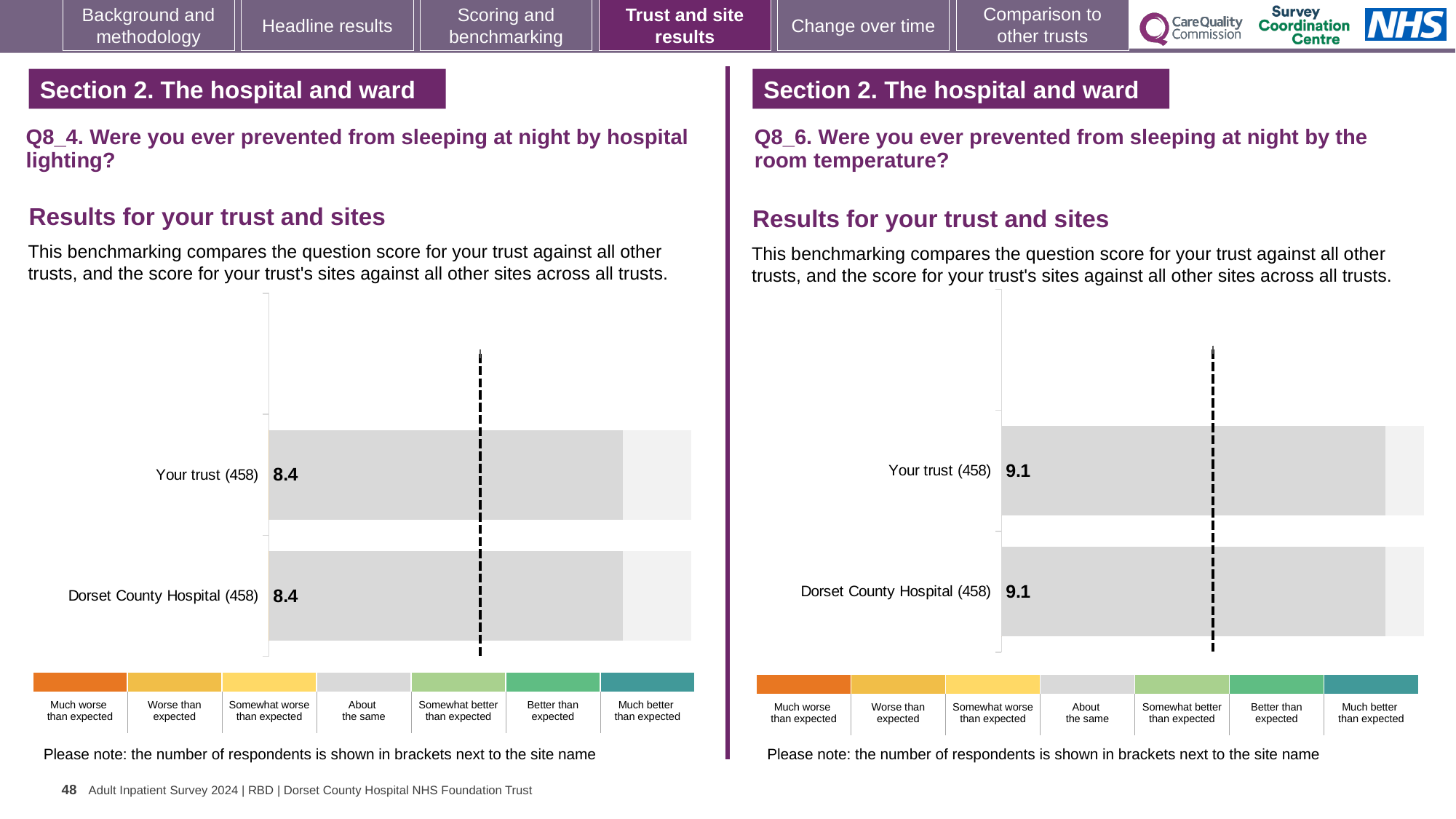
On the right chart (Q8_6, room temperature), what is the score for Dorset County Hospital (458)? 9.1 What kind of chart is used on the left (Q8_4, hospital lighting)? Bar chart How many bars are plotted on the right chart (Q8_6, room temperature)? 2 Which question does the right chart relate to? Q8_6. Were you ever prevented from sleeping at night by the room temperature? On the left chart (Q8_4, hospital lighting), what is the difference between the score for Your trust and the score for Dorset County Hospital? 0.0 On the left chart (Q8_4, hospital lighting), what is the score for Dorset County Hospital (458)? 8.4 How many bars are plotted on the left chart (Q8_4, hospital lighting)? 2 On the right chart (Q8_6, room temperature), what is the score for Your trust (458)? 9.1 How many respondents are shown in brackets for Your trust on the right chart (Q8_6, room temperature)? 458 On the right chart (Q8_6, room temperature), what is the difference between the score for Your trust and the score for Dorset County Hospital? 0.0 On the left chart (Q8_4, hospital lighting), what is the score for Your trust (458)? 8.4